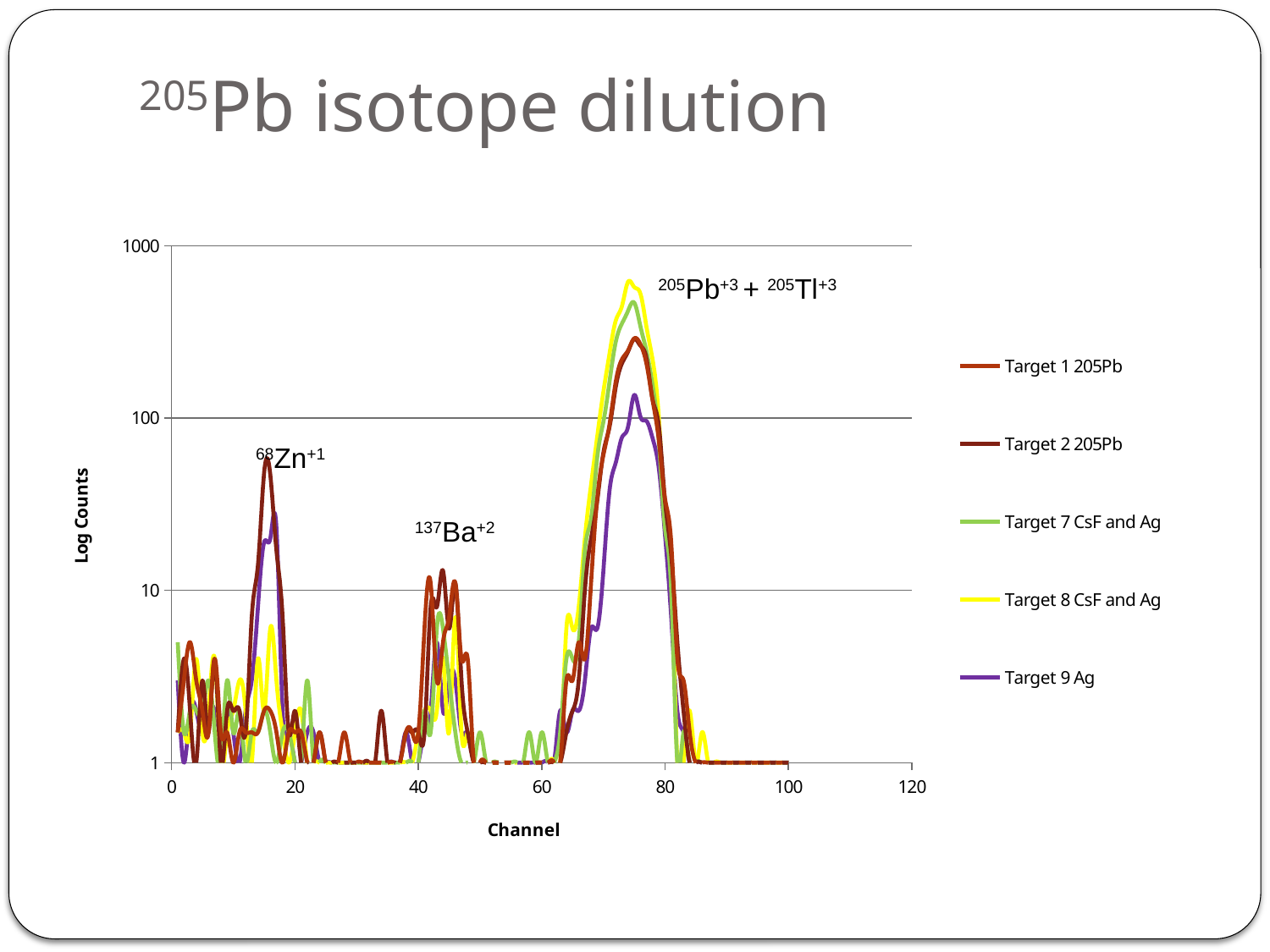
Is the peak value of Target 1 205Pb around channel 42 (the 137Ba+2 peak) greater or less than 100? less Is the peak value of Target 2 205Pb around channel 15 (the 68Zn+1 peak) greater or less than 10? greater Which series reaches the highest peak in the 205Pb+3 + 205Tl+3 region around channel 75? Target 8 CsF and Ag Is the peak value of Target 9 Ag around channel 75 greater or less than 1000? less What kind of chart is shown on the slide? line chart Which series has the lowest peak in the 205Pb+3 + 205Tl+3 region around channel 75? Target 9 Ag At the peak around channel 75, which is larger: Target 8 CsF and Ag or Target 9 Ag? Target 8 CsF and Ag What is the first entry listed in the legend? Target 1 205Pb What is the title of the vertical axis? Log Counts How many series does the legend list? 5